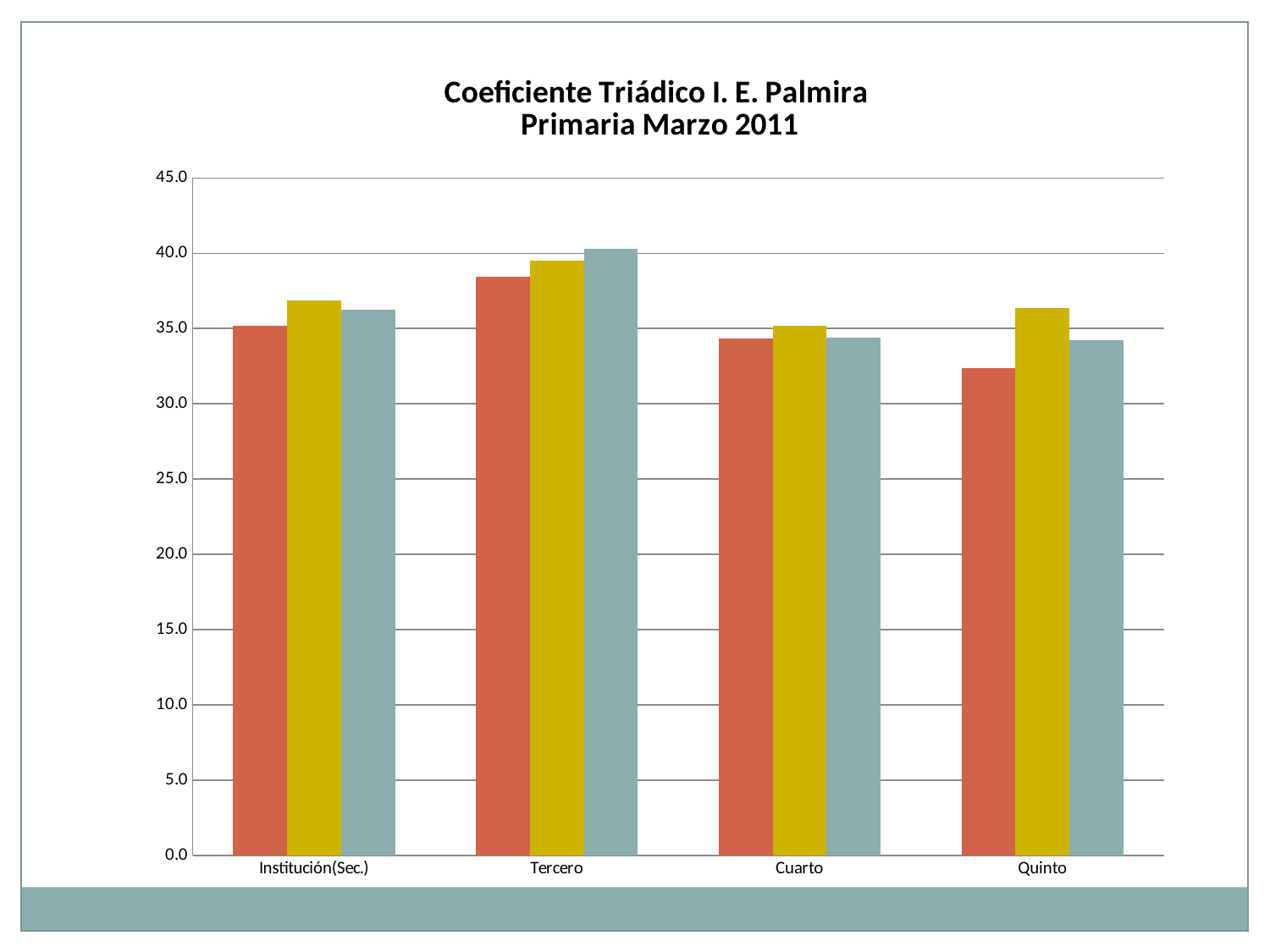
How many bars are plotted for each category? 3 How many categories are shown on the x axis? 4 What is the title of the chart? Coeficiente Triádico I. E. Palmira Primaria Marzo 2011 Is the value of the red bar for Tercero greater or less than 35.0? greater Is the value of the yellow bar for Institución(Sec.) greater or less than 35.0? greater Which category contains the lowest bar on the chart? Quinto Which is larger, the blue-grey bar for Institución(Sec.) or the blue-grey bar for Cuarto? Institución(Sec.) What kind of chart is shown on the slide? bar chart Which is larger, the red bar for Tercero or the red bar for Quinto? Tercero Is the value of the yellow bar for Quinto greater or less than 35.0? greater Which category has the tallest bars overall? Tercero